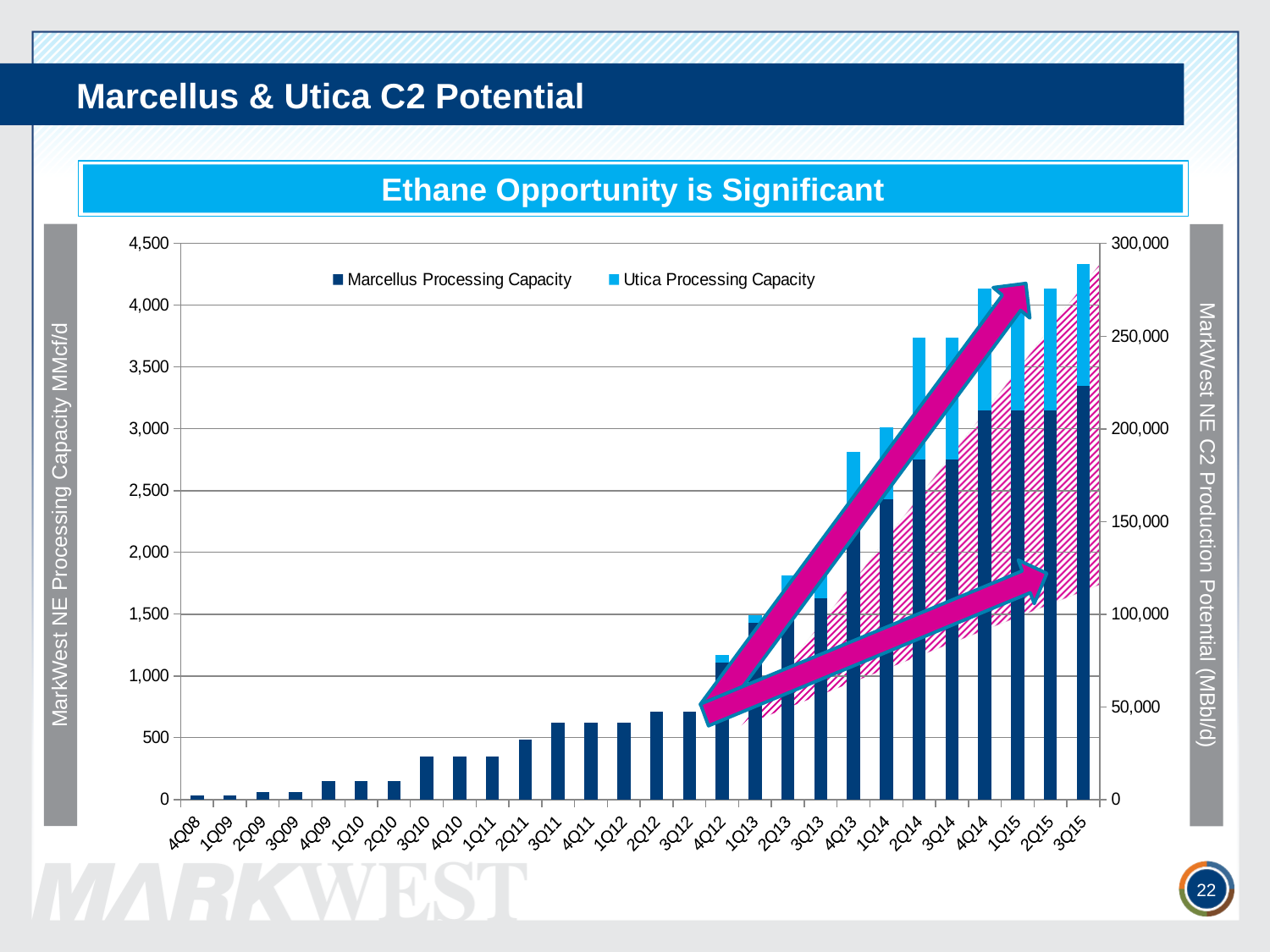
Is the Marcellus Processing Capacity value for 3Q15 greater or less than 3,000? greater How many series does the legend list? 2 How many quarters are shown along the x axis? 28 Do the stacked bar values generally rise or fall from 4Q08 to 3Q15? rise Is the total stacked bar for 3Q15 greater or less than 4,000? greater Is the Marcellus Processing Capacity value for 4Q12 greater or less than 1,000? greater Which series is shown in light blue in the legend? Utica Processing Capacity What kind of chart is shown on the slide? bar chart Which quarter has the tallest stacked bar? 3Q15 What is the label of the left vertical axis? MarkWest NE Processing Capacity MMcf/d